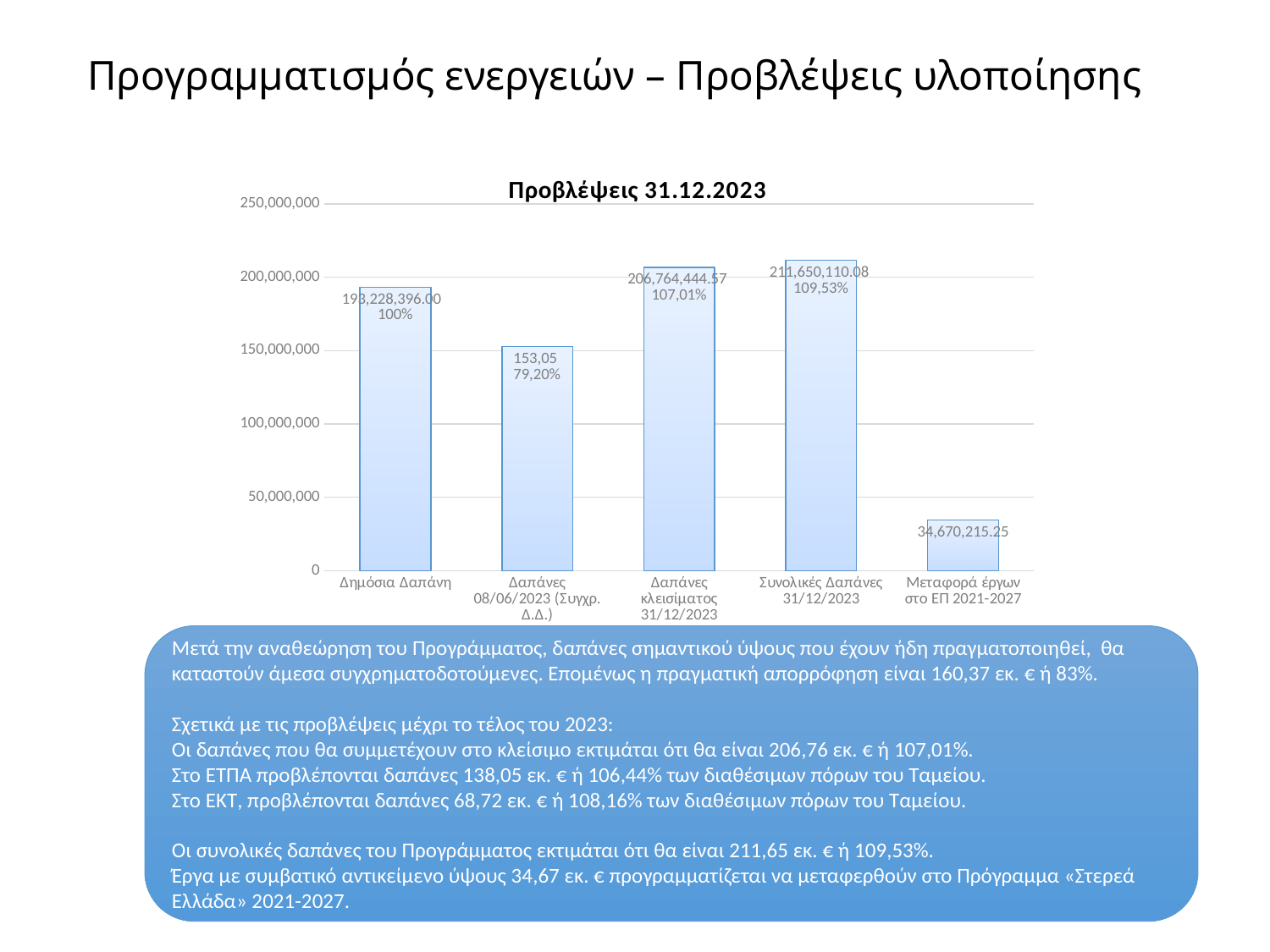
Which category has the highest value? Συνολικές Δαπάνες 31/12/2023 Which is larger: the value for Δημόσια Δαπάνη or the value for Δαπάνες κλεισίματος 31/12/2023? Δαπάνες κλεισίματος 31/12/2023 What percentage is shown for Συνολικές Δαπάνες 31/12/2023? 109,53% Which category has the lowest value? Μεταφορά έργων στο ΕΠ 2021-2027 What is the title of the chart? Προβλέψεις 31.12.2023 What type of chart is shown on the slide? bar chart How many categories are plotted in the chart? 5 What is the value shown for Μεταφορά έργων στο ΕΠ 2021-2027? 34,670,215.25 Is the value for Δαπάνες 08/06/2023 (Συγχρ. Δ.Δ.) greater or less than 200,000,000? less What is the value shown for Δαπάνες κλεισίματος 31/12/2023? 206,764,444.57 What percentage is shown for Δαπάνες 08/06/2023 (Συγχρ. Δ.Δ.)? 79,20% What is the value shown for Συνολικές Δαπάνες 31/12/2023? 211,650,110.08